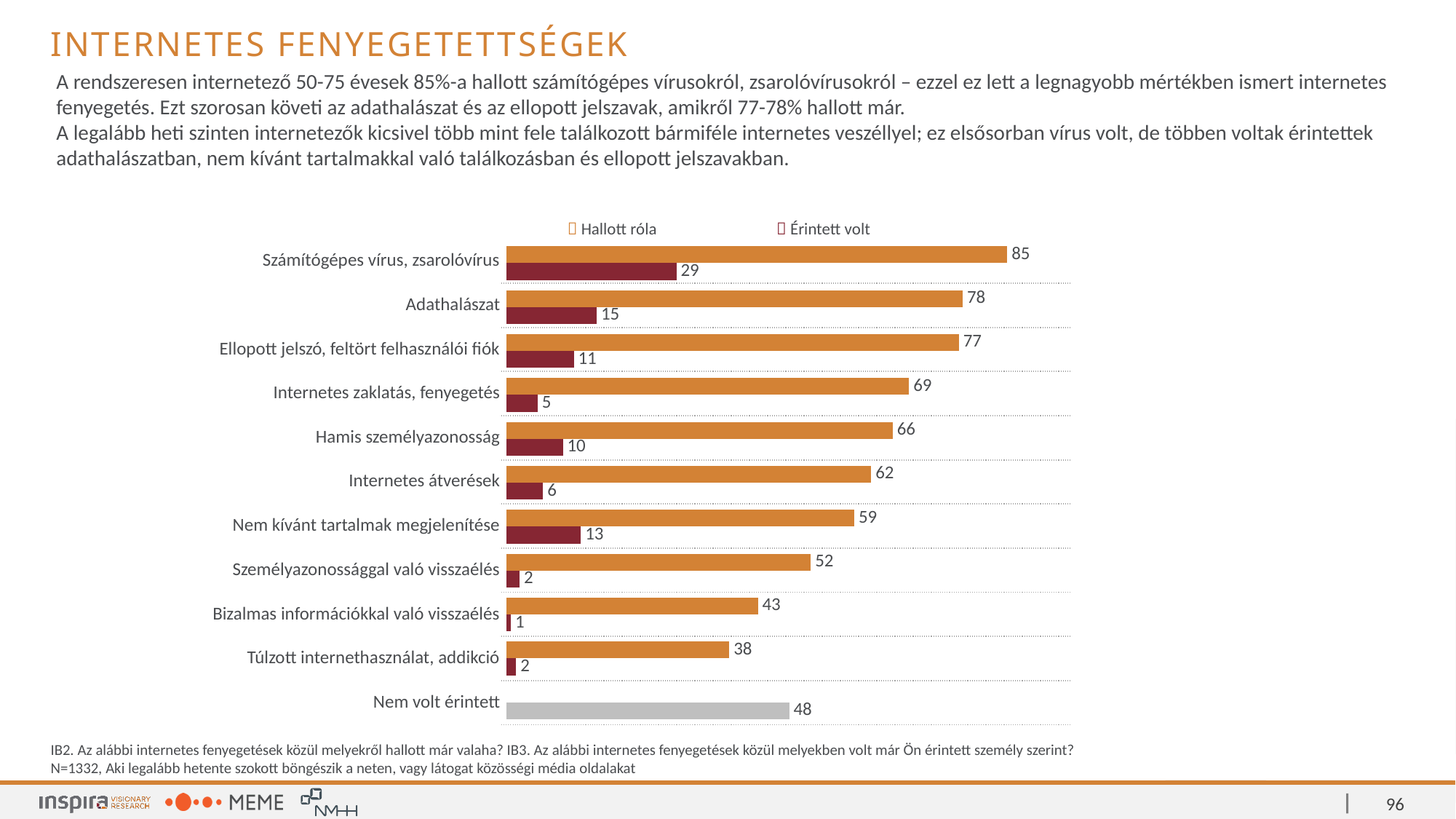
What value is shown for the grey bar Nem volt érintett? 48 What is the "Érintett volt" value for Számítógépes vírus, zsarolóvírus? 29 What is the "Hallott róla" value for Túlzott internethasználat, addikció? 38 Which category has the highest "Hallott róla" value? Számítógépes vírus, zsarolóvírus What is the "Hallott róla" value for Adathalászat? 78 Which is larger: the "Hallott róla" value for Internetes zaklatás, fenyegetés or for Hamis személyazonosság? Internetes zaklatás, fenyegetés Which category has the lowest "Érintett volt" value? Bizalmas információkkal való visszaélés What is the "Érintett volt" value for Nem kívánt tartalmak megjelenítése? 13 How many series does the legend list? 2 What is the difference between the "Hallott róla" and "Érintett volt" values for Adathalászat? 63 What kind of chart is shown on the slide? Bar chart Which colour represents the "Hallott róla" series? Orange